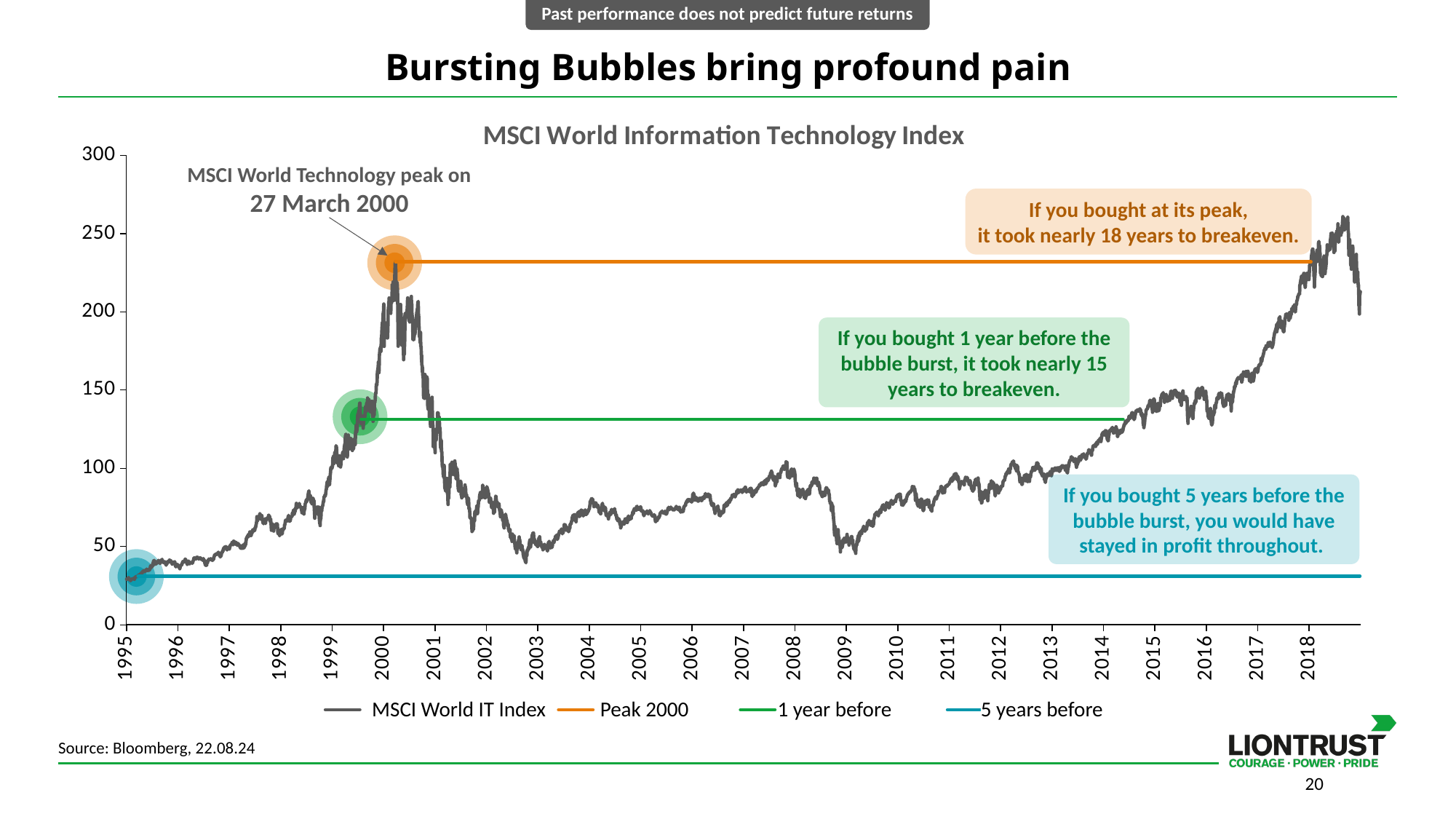
Is the value of the MSCI World IT Index at the start of 1995 greater or less than 50? less Which series is drawn in orange according to the legend? Peak 2000 How many year labels are shown on the x axis? 24 Does the MSCI World IT Index generally rise or fall between 2009 and 2018? rise On what date did the MSCI World Technology index peak, according to the annotation? 27 March 2000 Does the MSCI World IT Index rise or fall between its 2000 peak and 2003? fall Is the value of the MSCI World IT Index at its 2000 peak greater or less than 200? greater What is the title of the chart? MSCI World Information Technology Index How many series does the legend list? 4 Is the value of the MSCI World IT Index at its low point in 2009 greater or less than 100? less What kind of chart is shown on the slide? line chart